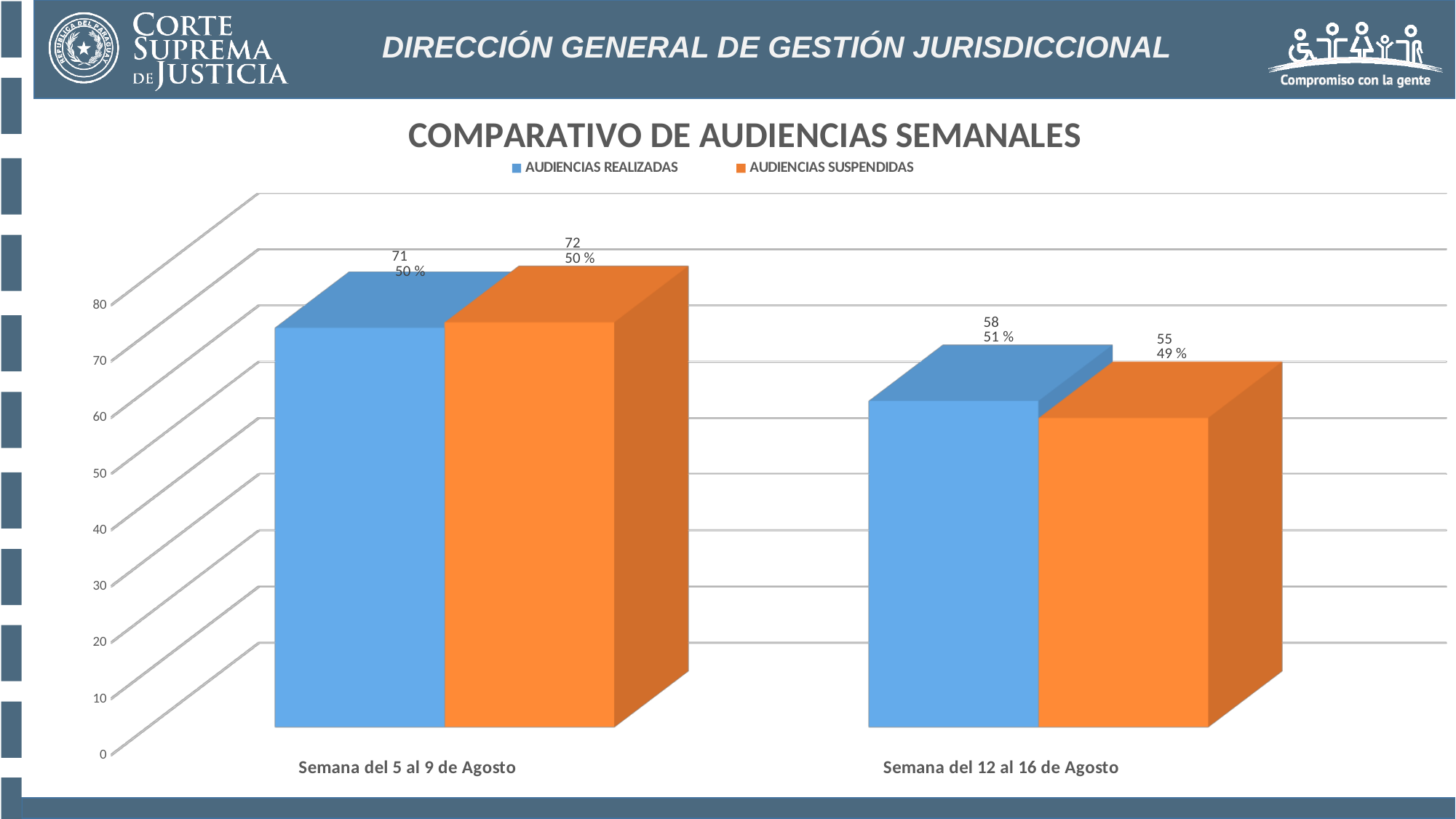
How many weeks (categories) are shown on the x axis? 2 What percentage is shown for AUDIENCIAS REALIZADAS in Semana del 12 al 16 de Agosto? 51 % What is the difference between AUDIENCIAS REALIZADAS and AUDIENCIAS SUSPENDIDAS for Semana del 12 al 16 de Agosto? 3 What is the value of AUDIENCIAS SUSPENDIDAS for Semana del 12 al 16 de Agosto? 55 What kind of chart is shown on the slide? Bar chart What is the value of AUDIENCIAS SUSPENDIDAS for Semana del 5 al 9 de Agosto? 72 What is the value of AUDIENCIAS REALIZADAS for Semana del 5 al 9 de Agosto? 71 What is the difference in AUDIENCIAS REALIZADAS between Semana del 5 al 9 de Agosto and Semana del 12 al 16 de Agosto? 13 Which week has the higher value of AUDIENCIAS SUSPENDIDAS? Semana del 5 al 9 de Agosto How many series does the legend list? 2 What is the value of AUDIENCIAS REALIZADAS for Semana del 12 al 16 de Agosto? 58 What is the title of the chart? COMPARATIVO DE AUDIENCIAS SEMANALES